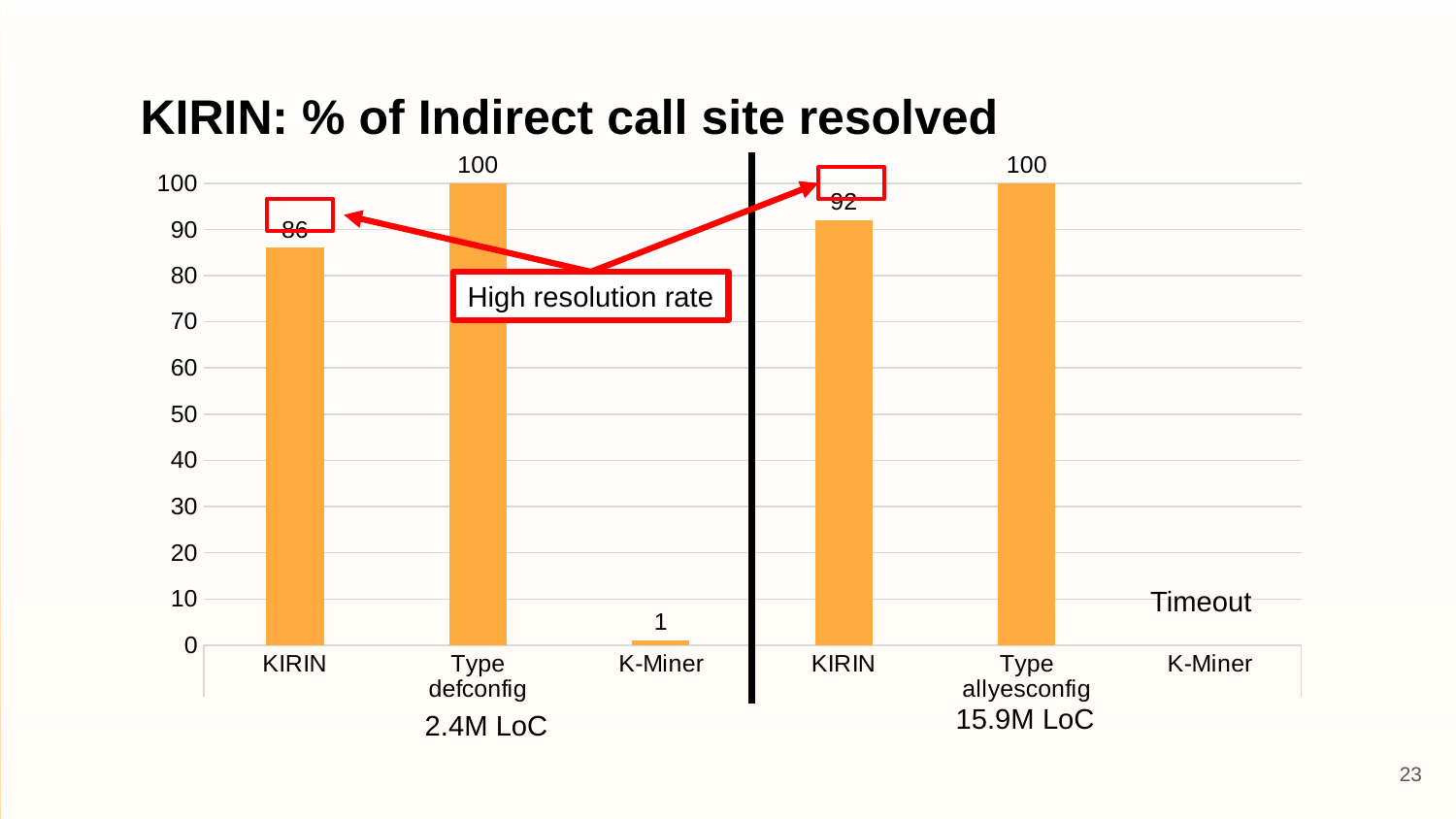
What is the difference between the KIRIN values in the allyesconfig group and the defconfig group? 6 What is the value for Type in the allyesconfig (15.9M LoC) group? 100 Which is larger: KIRIN in the defconfig group or KIRIN in the allyesconfig group? KIRIN in the allyesconfig group Which category has the lowest value in the defconfig (2.4M LoC) group? K-Miner Is the value for KIRIN in the defconfig (2.4M LoC) group greater or less than 80? greater What is the title of the chart on the slide? KIRIN: % of Indirect call site resolved What kind of chart is shown on the slide? Bar chart What is the value for KIRIN in the allyesconfig (15.9M LoC) group? 92 What is the value for K-Miner in the defconfig (2.4M LoC) group? 1 What is the difference between the Type and KIRIN values in the defconfig (2.4M LoC) group? 14 What is the value for KIRIN in the defconfig (2.4M LoC) group? 86 What is shown for K-Miner in the allyesconfig (15.9M LoC) group instead of a bar? Timeout